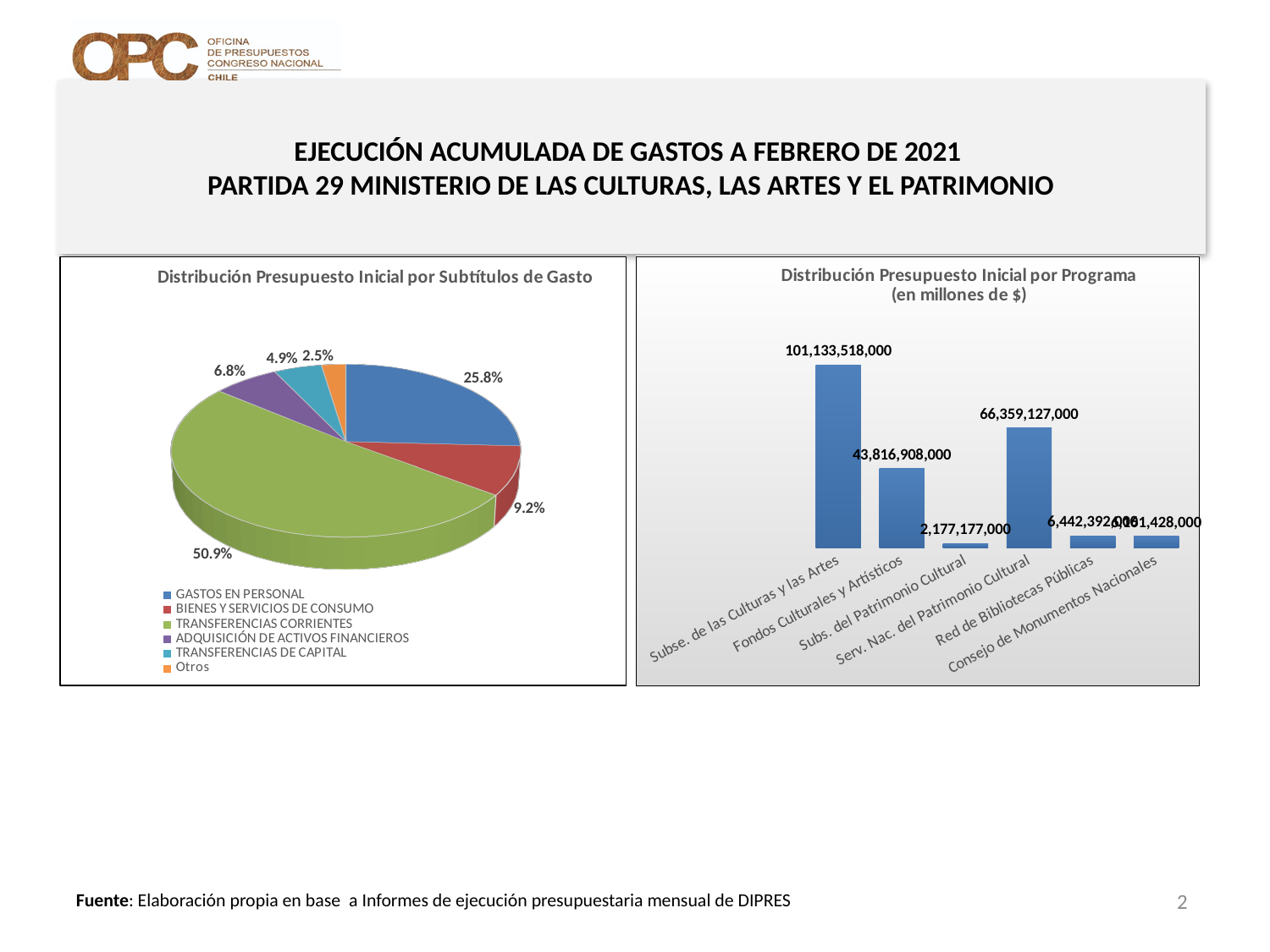
In the pie chart 'Distribución Presupuesto Inicial por Subtítulos de Gasto', which is larger: ADQUISICIÓN DE ACTIVOS FINANCIEROS or TRANSFERENCIAS DE CAPITAL? ADQUISICIÓN DE ACTIVOS FINANCIEROS In the bar chart 'Distribución Presupuesto Inicial por Programa', what is the value for Subse. de las Culturas y las Artes? 101,133,518,000 In the bar chart 'Distribución Presupuesto Inicial por Programa', which program has the lowest value? Subs. del Patrimonio Cultural In the pie chart 'Distribución Presupuesto Inicial por Subtítulos de Gasto', what share does TRANSFERENCIAS CORRIENTES have? 50.9% In the bar chart 'Distribución Presupuesto Inicial por Programa', how many programs are shown? 6 In the pie chart 'Distribución Presupuesto Inicial por Subtítulos de Gasto', which category has the smallest share? Otros What kind of chart is 'Distribución Presupuesto Inicial por Programa (en millones de $)'? Bar chart In the bar chart 'Distribución Presupuesto Inicial por Programa', what is the value for Serv. Nac. del Patrimonio Cultural? 66,359,127,000 In the bar chart 'Distribución Presupuesto Inicial por Programa', which program has the highest value? Subse. de las Culturas y las Artes In the pie chart 'Distribución Presupuesto Inicial por Subtítulos de Gasto', how many categories does the legend list? 6 In the pie chart 'Distribución Presupuesto Inicial por Subtítulos de Gasto', what share does GASTOS EN PERSONAL have? 25.8% In the pie chart 'Distribución Presupuesto Inicial por Subtítulos de Gasto', what is the difference between the shares of GASTOS EN PERSONAL and BIENES Y SERVICIOS DE CONSUMO? 16.6%